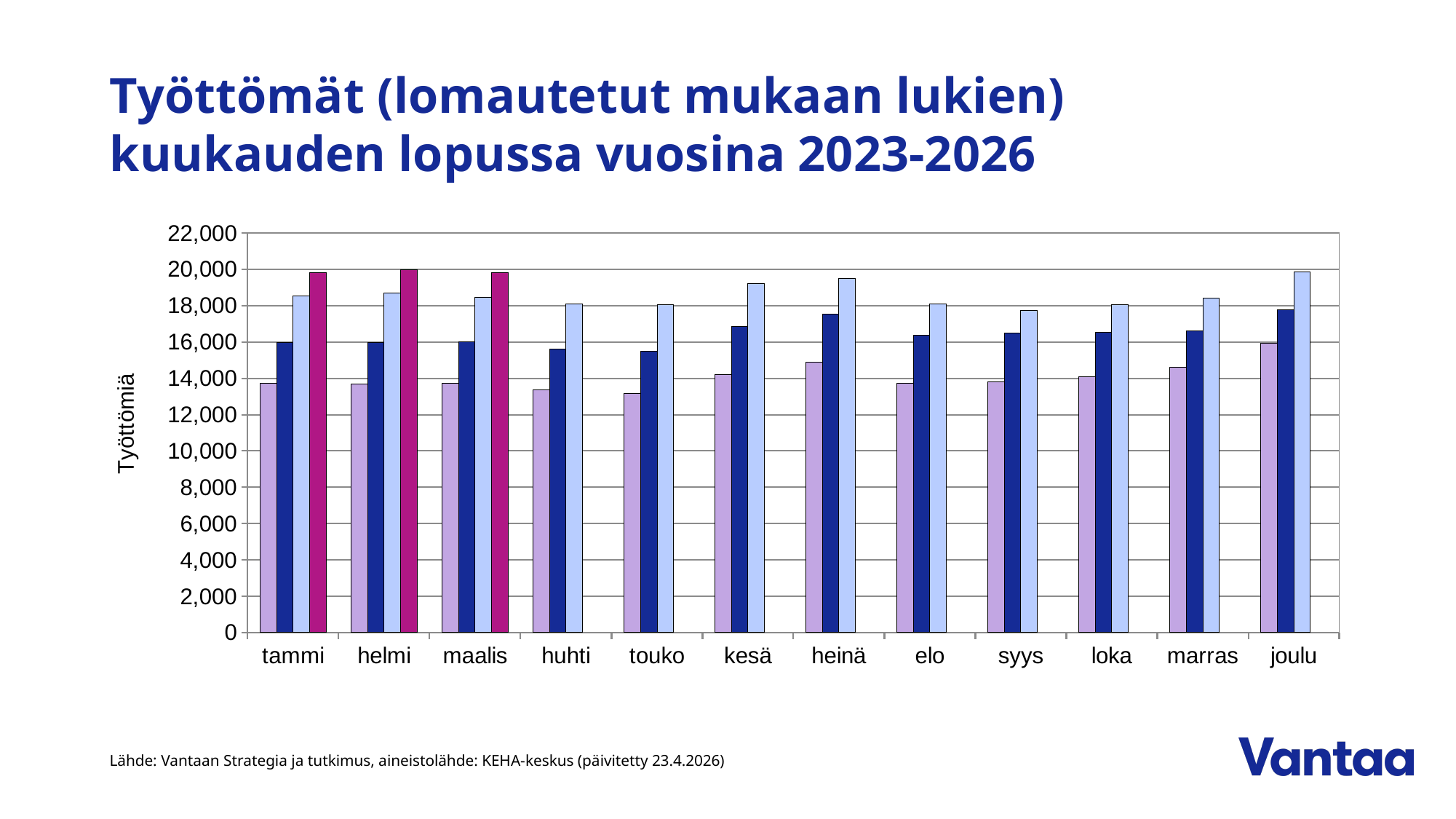
What kind of chart is shown on the slide? bar chart Is the value of the magenta bar for tammi greater or less than 18,000? greater In tammi, which is taller: the magenta bar or the light purple bar? the magenta bar Among the light purple bars, which month has the highest value? joulu In joulu, which is taller: the light blue bar or the dark blue bar? the light blue bar Is the value of the light purple bar for touko greater or less than 14,000? less How many months are shown on the x axis of the chart? 12 What is the label on the vertical axis of the chart? Työttömiä How many bars are shown for the month tammi? 4 Is the value of the light blue bar for kesä greater or less than 18,000? greater How many bars are shown for the month huhti? 3